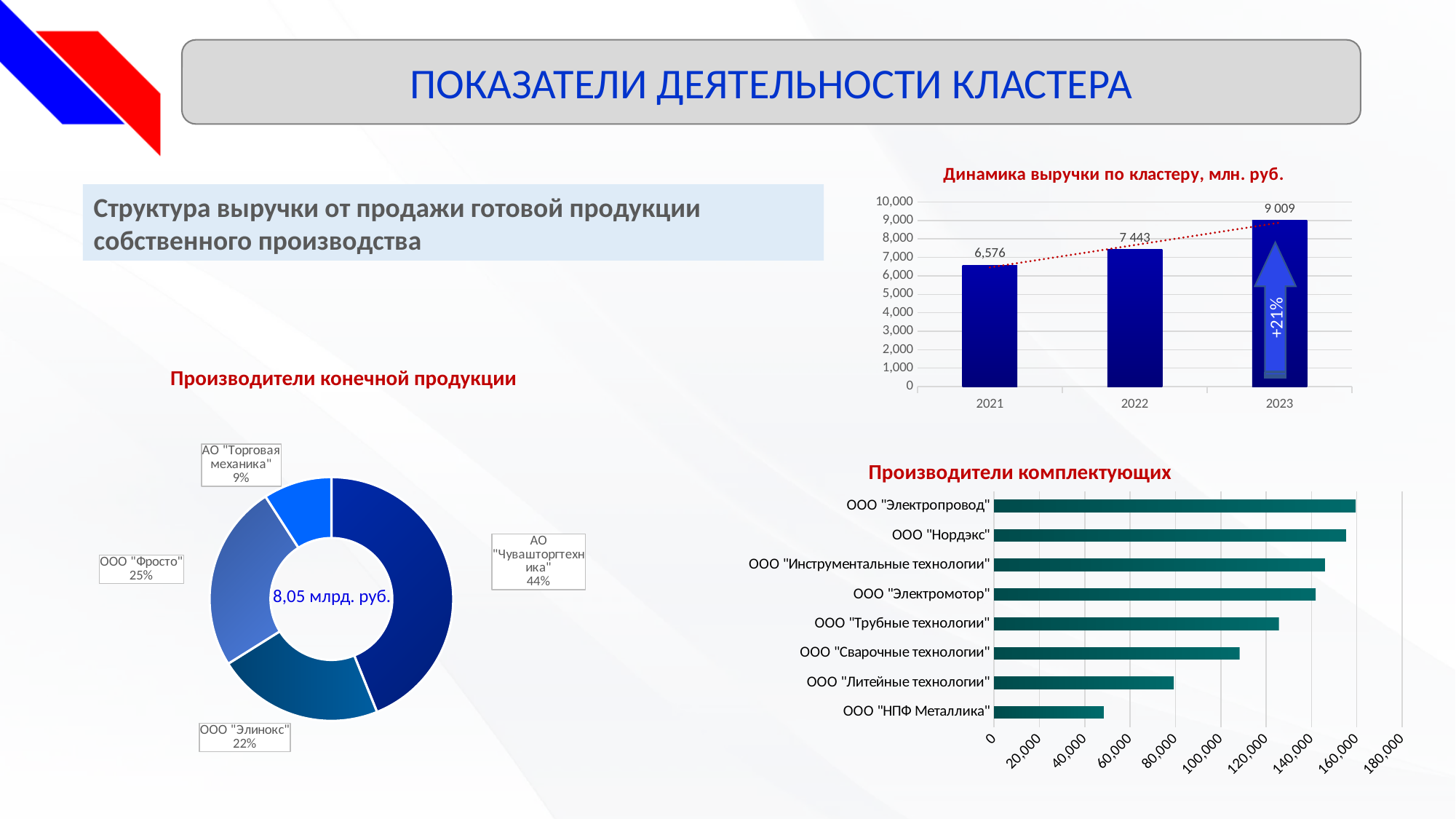
In the chart "Производители конечной продукции", what total value is shown in the centre of the donut? 8,05 млрд. руб. In the chart "Динамика выручки по кластеру, млн. руб.", which year has the highest value? 2023 In the chart "Производители комплектующих", is the value for ООО "НПФ Металлика" greater or less than 60,000? less In the chart "Динамика выручки по кластеру, млн. руб.", what percentage growth is shown on the 2023 bar? +21% In the chart "Производители комплектующих", which company has the longest bar? ООО "Электропровод" In the chart "Производители конечной продукции", what share does ООО "Фросто" have? 25% In the chart "Динамика выручки по кластеру, млн. руб.", what is the value for 2021? 6,576 In the chart "Производители конечной продукции", what share does АО "Чувашторгтехника" have? 44% How many companies are listed in the chart "Производители комплектующих"? 8 In the chart "Динамика выручки по кластеру, млн. руб.", what is the value for 2023? 9 009 In the chart "Динамика выручки по кластеру, млн. руб.", do the values rise or fall from 2021 to 2023? rise In the chart "Производители конечной продукции", which company has the smallest share? АО "Торговая механика"